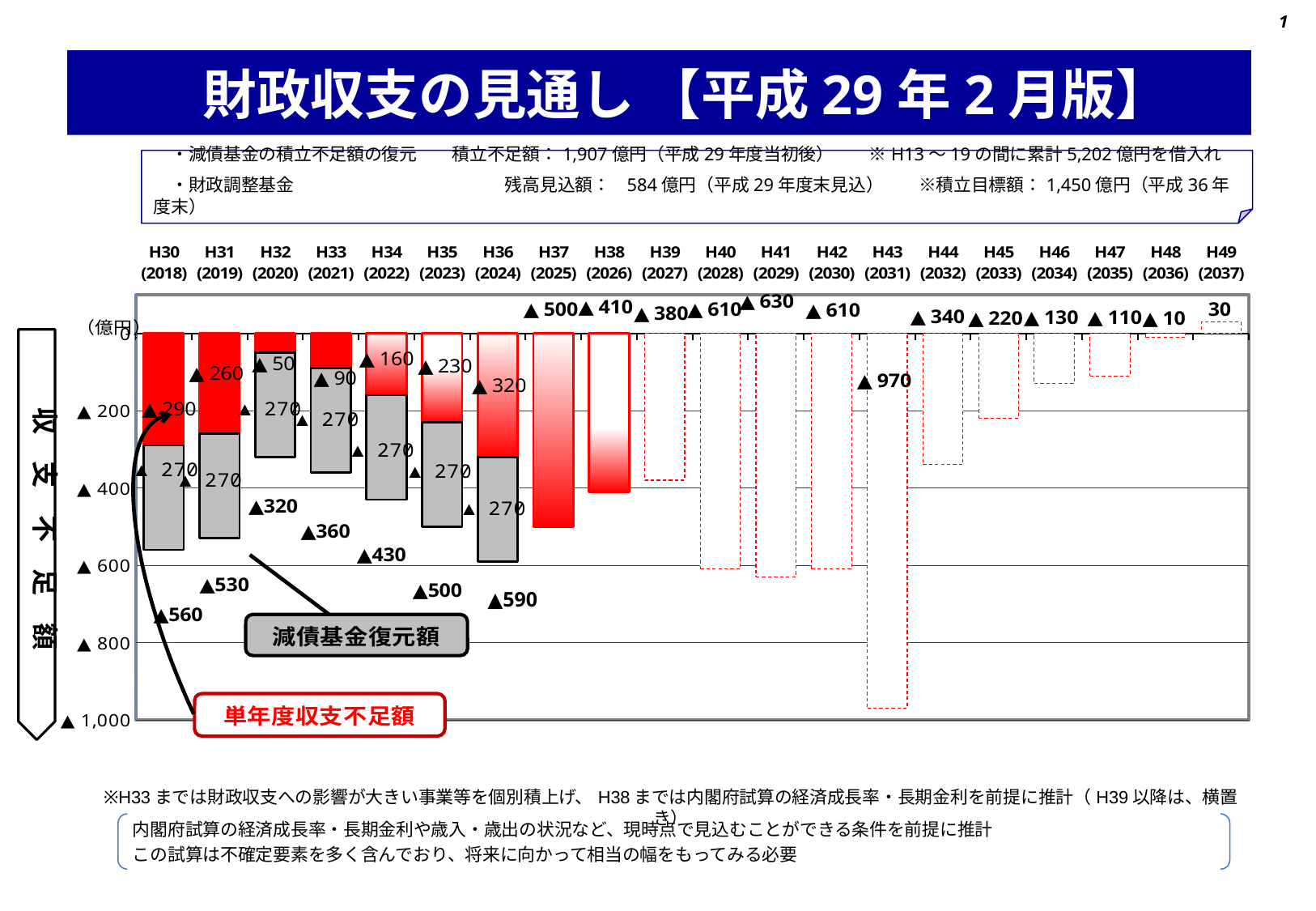
What is the 単年度収支不足額 (red segment) value for H30 (2018)? ▲290 What is the total value labelled for the H36 (2024) bar? ▲590 What unit is shown on the y axis of the chart? 億円 Which is larger in magnitude, the value for H41 (2029) or the value for H39 (2027)? H41 (2029) What is the 減債基金復元額 (gray segment) value for H33 (2021)? 270 What kind of chart is shown on the slide? bar chart Which fiscal year has the largest deficit (longest bar) in the chart? H43 (2031) What is the value labelled for H48 (2036)? ▲10 What is the value labelled for H43 (2031)? ▲970 How many fiscal years (categories) are shown along the x axis of the chart? 20 What is the value labelled for H49 (2037)? 30 What is the difference between the red segment values for H36 (2024) and H32 (2020)? 270